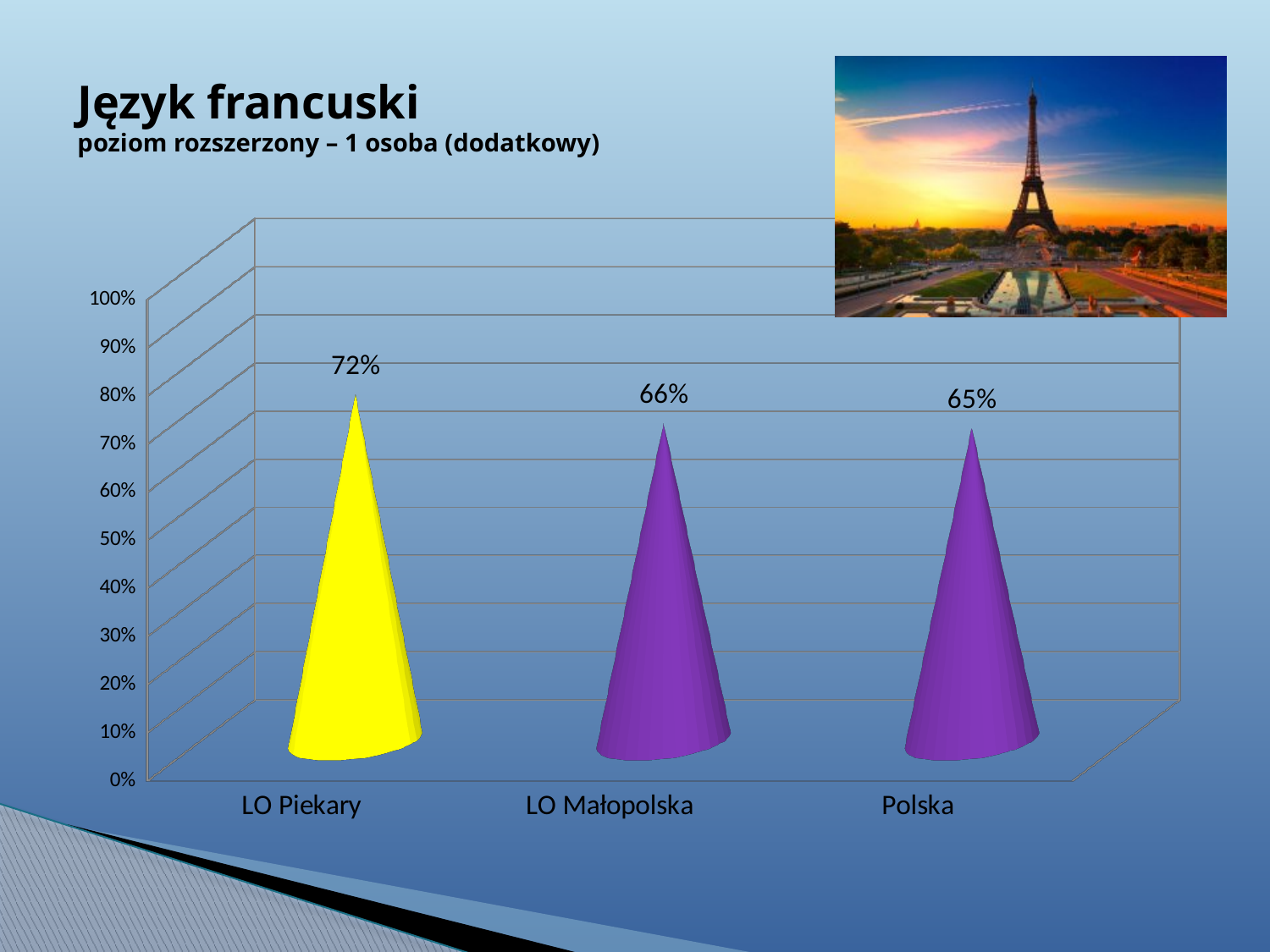
Which category has the highest value? LO Piekary What is the difference between the values for LO Piekary and LO Małopolska? 6% Is the value for LO Małopolska greater or less than 50%? greater Which is larger, the value for LO Piekary or the value for Polska? LO Piekary What is the difference between the values for LO Piekary and Polska? 7% What colour is the bar for LO Piekary? yellow How many categories are shown on the x axis? 3 Which category has the lowest value? Polska What kind of chart is shown on the slide? bar chart What is the value for LO Piekary? 72% What is the value for LO Małopolska? 66% What is the value for Polska? 65%